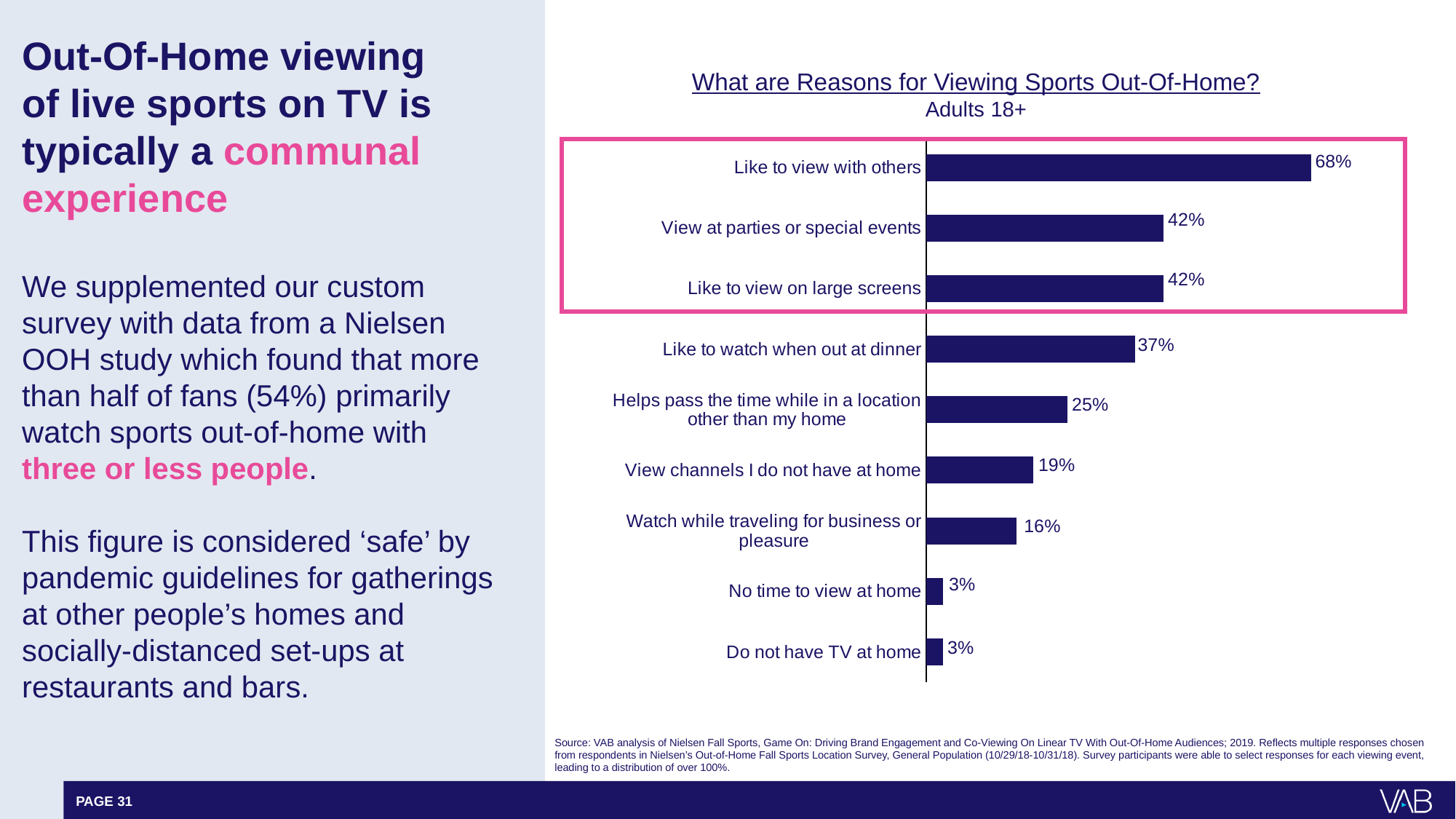
What is the value for 'View channels I do not have at home'? 19% What is the value for 'Watch while traveling for business or pleasure'? 16% What kind of chart is shown on the slide? Bar chart What is the difference between 'Helps pass the time while in a location other than my home' and 'No time to view at home'? 22% Which reason has the highest percentage in the chart? Like to view with others What is the title of the chart? What are Reasons for Viewing Sports Out-Of-Home? What percentage of adults 18+ cite 'Like to view with others' as a reason for viewing sports out-of-home? 68% What is the value for 'Like to watch when out at dinner'? 37% How many categories are enclosed by the pink highlight box in the chart? 3 Which is larger: 'Like to watch when out at dinner' or 'View channels I do not have at home'? Like to watch when out at dinner How many reasons (categories) are shown in the chart? 9 What is the difference between 'Like to view with others' and 'View at parties or special events'? 26%